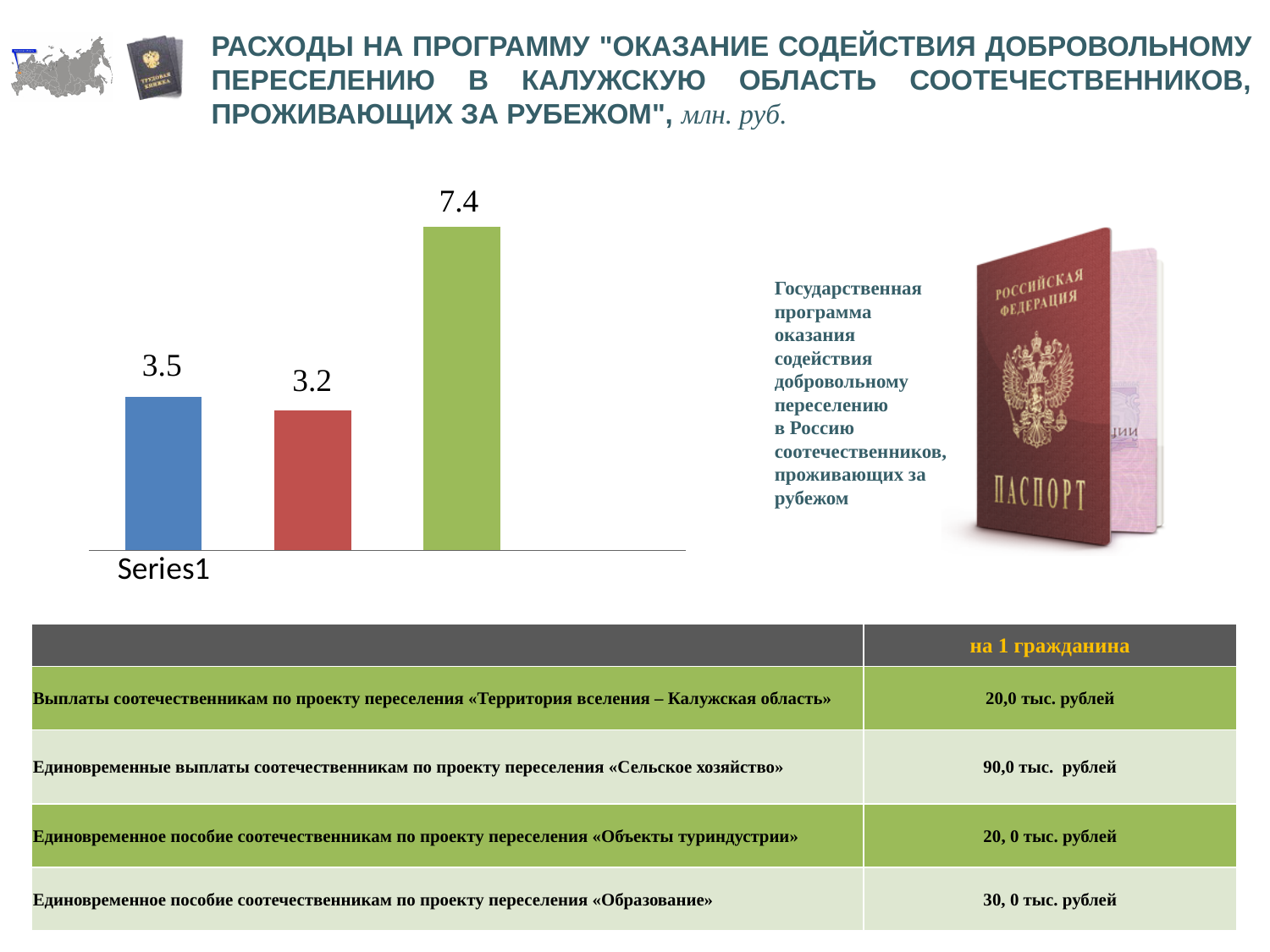
What is the value of the first (blue) bar in the chart? 3.5 What is the value of the second (red) bar in the chart? 3.2 Which bar has the highest value in the chart? the third (green) bar, 7.4 Which bar has the lowest value in the chart? the second (red) bar, 3.2 How many bars are plotted in the chart? 3 What type of chart is shown on the slide? bar chart What is the difference between the green bar (7.4) and the blue bar (3.5)? 3.9 Which is larger, the value of the blue bar or the value of the red bar? the blue bar (3.5) What is the difference between the blue bar (3.5) and the red bar (3.2)? 0.3 In what units are the chart values expressed, according to the slide title? млн. руб. Do the bar values rise or fall from the second bar to the third bar? rise What is the value of the third (green) bar in the chart? 7.4